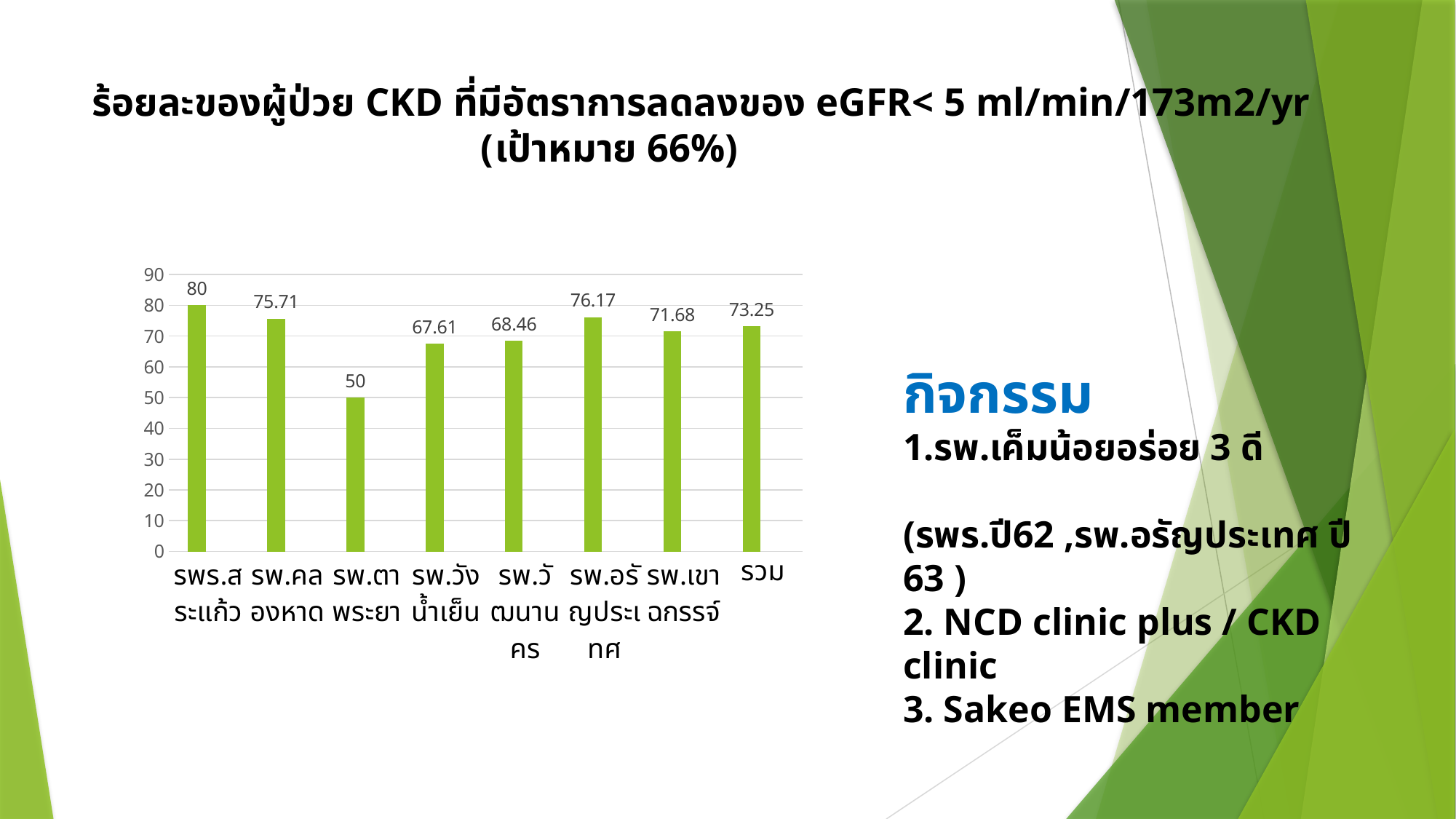
What is the value for รพร.สระแก้ว? 80 What is the value for รพ.ตาพระยา? 50 Which category has the lowest value? รพ.ตาพระยา What kind of chart is shown on the slide? bar chart What target percentage is stated in the chart title? 66% What is the value for รวม? 73.25 How many categories are shown on the x axis? 8 What is the difference between the values for รพร.สระแก้ว and รพ.ตาพระยา? 30 Which is larger, the value for รพ.คลองหาด or the value for รพ.เขาฉกรรจ์? รพ.คลองหาด Is the value for รพ.วังน้ำเย็น greater or less than 60? greater What is the value for รพ.อรัญประเทศ? 76.17 Which category has the highest value? รพร.สระแก้ว